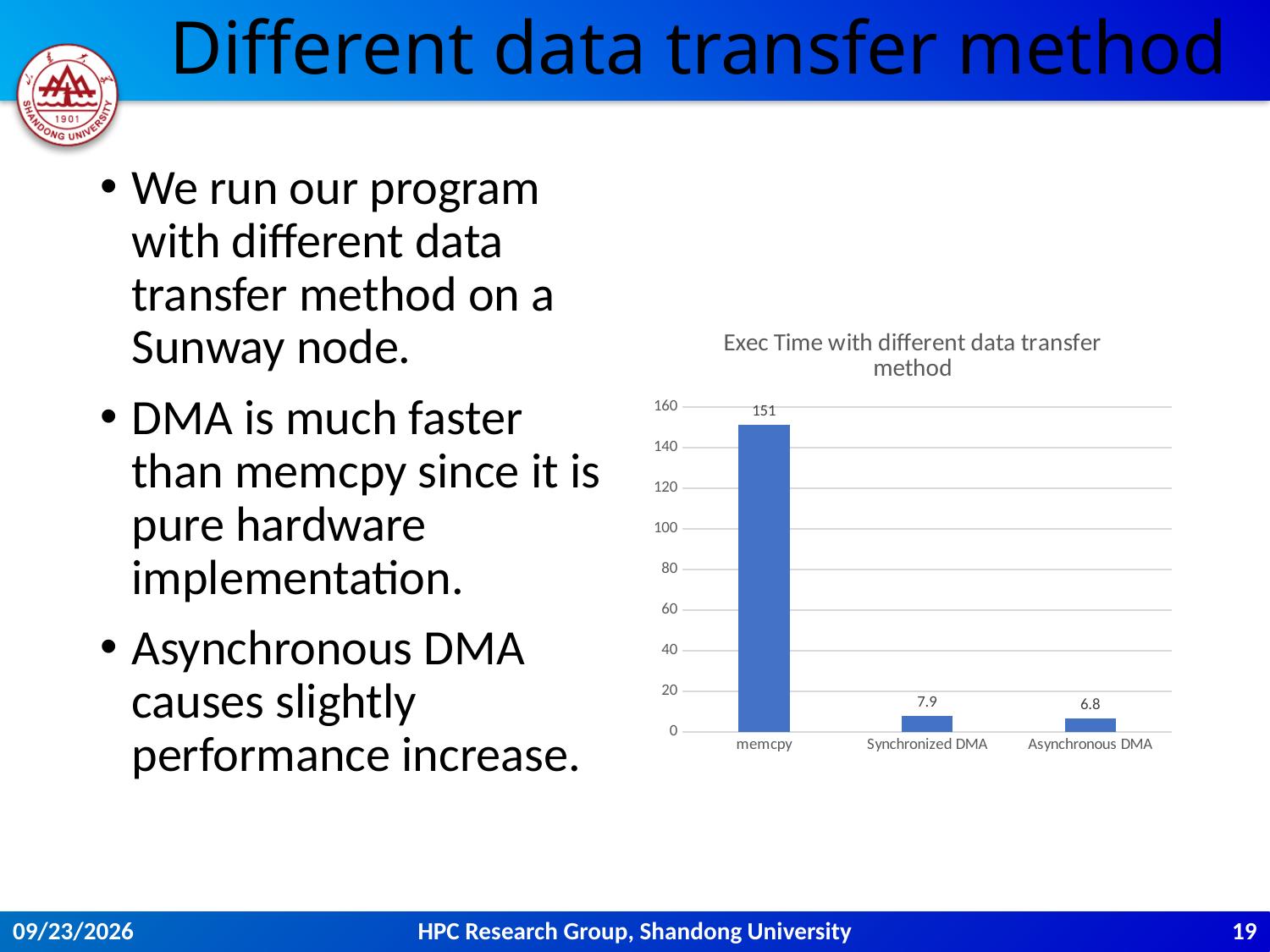
How many data transfer methods are shown in the chart? 3 What kind of chart is shown on the slide? bar chart What is the value for memcpy? 151 Which data transfer method has the lowest execution time? Asynchronous DMA What is the value for Synchronized DMA? 7.9 What is the difference between the values for memcpy and Synchronized DMA? 143.1 Which is larger, the value for Synchronized DMA or the value for Asynchronous DMA? Synchronized DMA What is the title of the chart? Exec Time with different data transfer method Which data transfer method has the highest execution time? memcpy What is the difference between the values for Synchronized DMA and Asynchronous DMA? 1.1 What is the value for Asynchronous DMA? 6.8 Is the value for memcpy greater or less than 140? greater